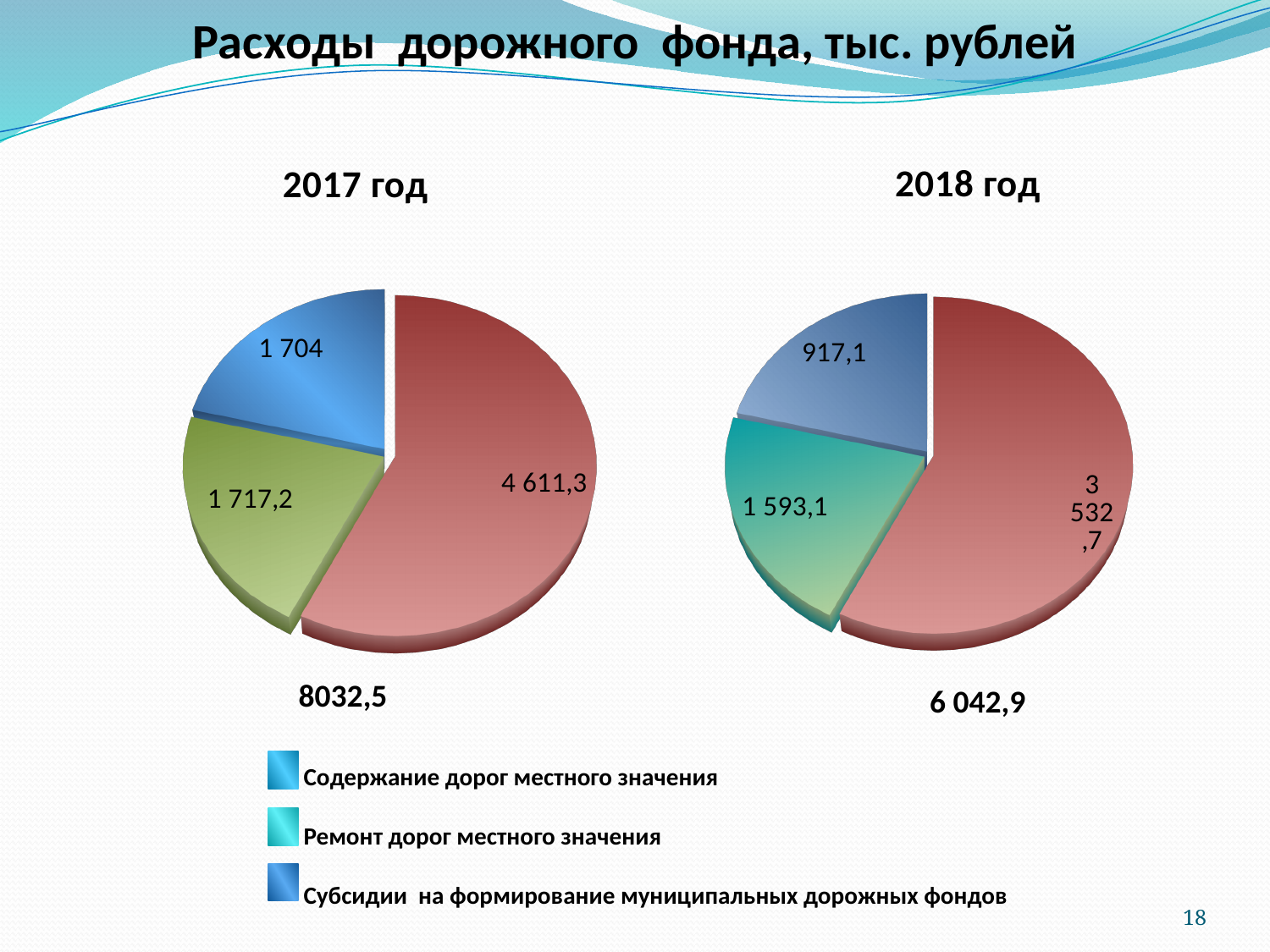
What total is printed below the 2018 год pie chart? 6 042,9 How many entries does the legend list? 3 How many slices does the 2018 год pie chart have? 3 In the 2017 год pie chart, what is the value of the largest slice? 4 611,3 Which is larger: the smallest slice in the 2017 год chart or the smallest slice in the 2018 год chart? The 2017 год chart (1 704) What type of charts are shown on the slide? Pie charts In the 2018 год pie chart, what is the value of the smallest slice? 917,1 In the 2017 год pie chart, what is the value of the green slice? 1 717,2 What is the title of the slide's charts? Расходы дорожного фонда, тыс. рублей What is the difference between the largest slice in the 2017 год chart (4 611,3) and the largest slice in the 2018 год chart (3 532,7)? 1 078,6 In the 2018 год pie chart, what is the value of the teal slice? 1 593,1 What total is printed below the 2017 год pie chart? 8032,5